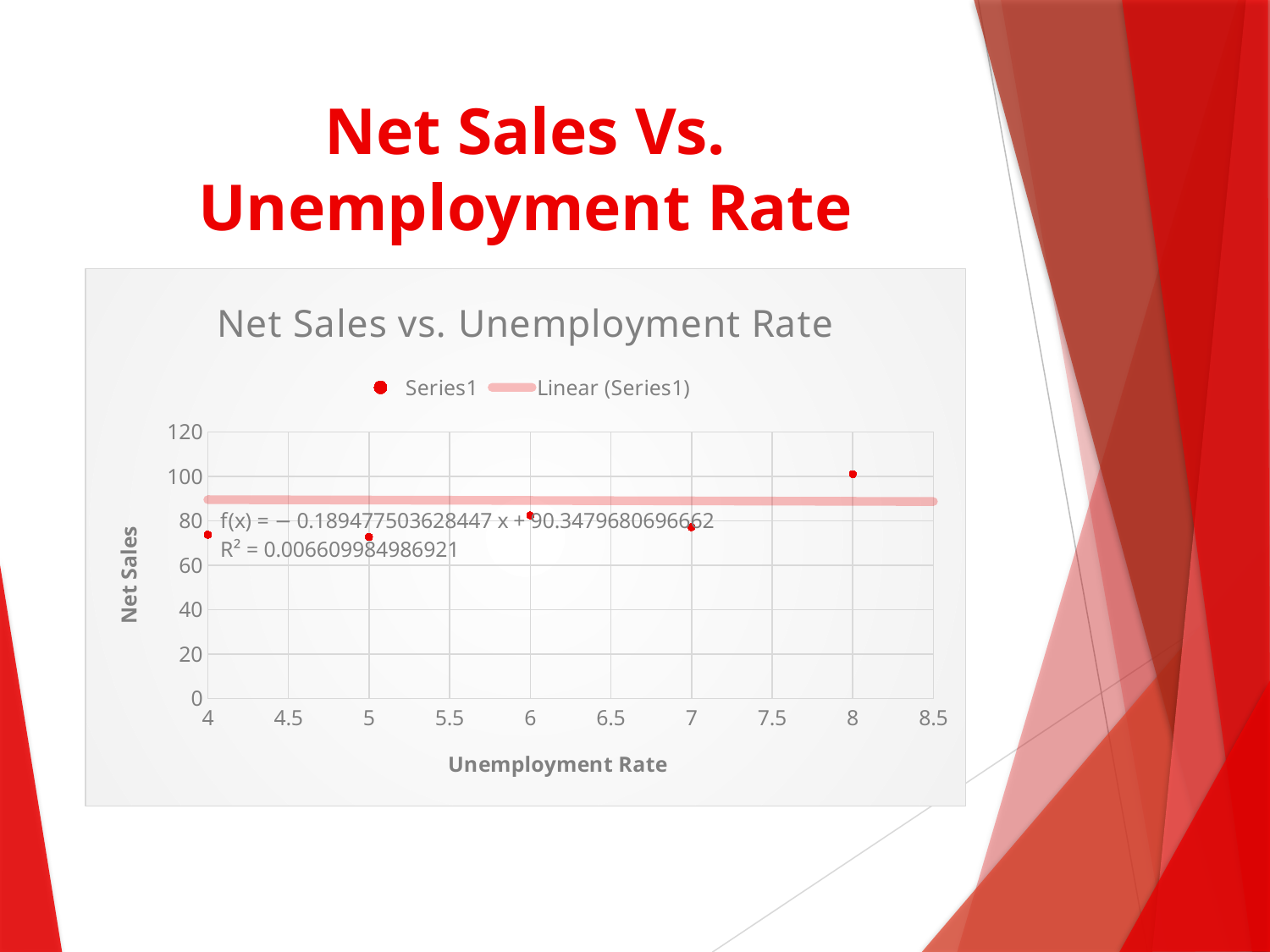
How many entries does the chart legend list? 2 Is the net sales value at an unemployment rate of 7 greater or less than 100? less At which unemployment rate is the plotted net sales value highest? 8 What is the label on the horizontal axis of the chart? Unemployment Rate What is the title of the chart? Net Sales vs. Unemployment Rate Is the net sales value at an unemployment rate of 8 greater or less than 80? greater Is the net sales value at an unemployment rate of 6 greater or less than 60? greater Which has the larger net sales value: the point at unemployment rate 8 or the point at unemployment rate 5? 8 What kind of chart is shown on the slide? scatter chart Which has the larger net sales value: the point at unemployment rate 6 or the point at unemployment rate 5? 6 How many data points are plotted in the chart? 5